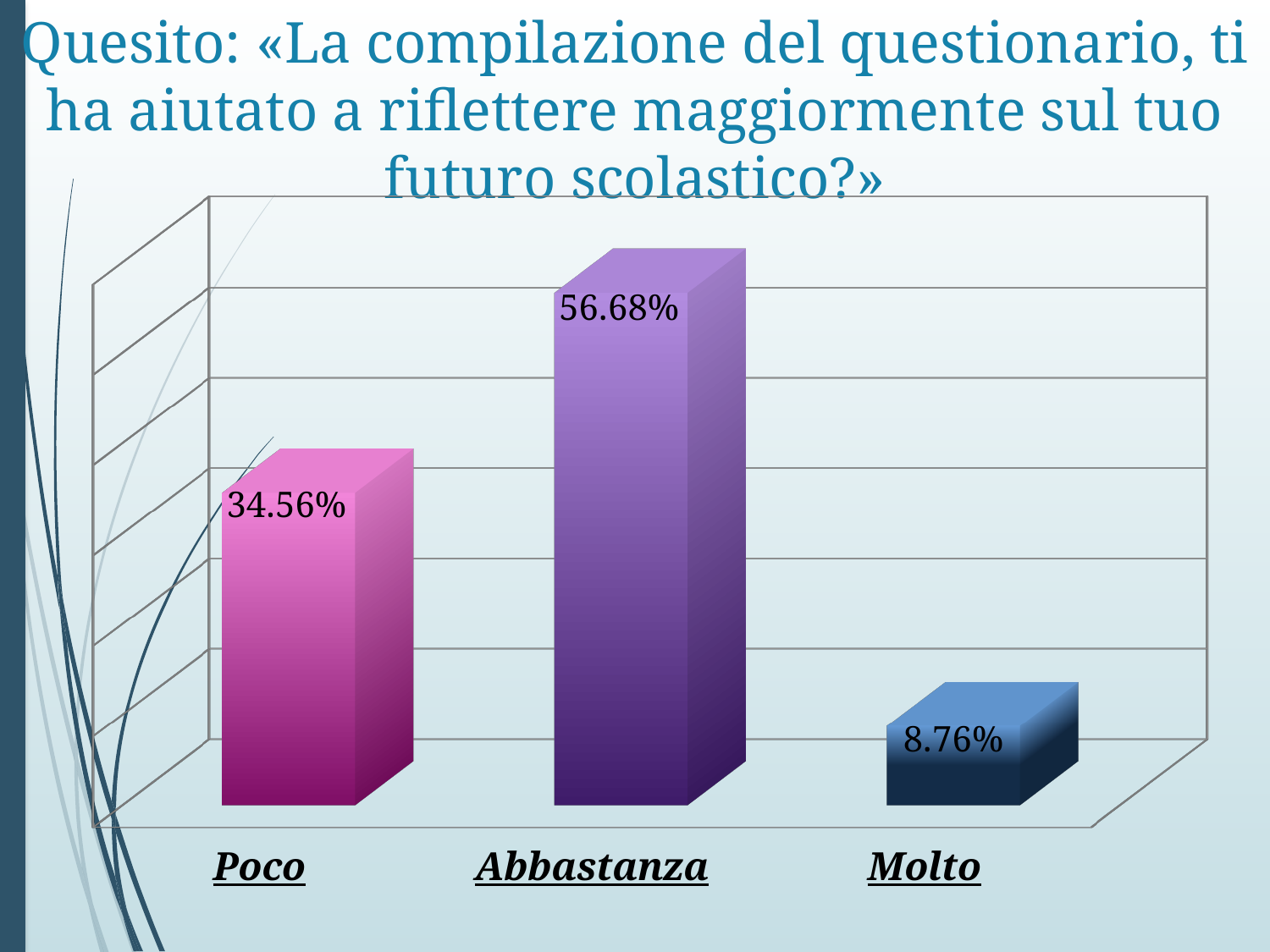
How many categories are shown in the chart? 3 What is the difference between the values for Poco and Molto? 25.80% What is the value for Molto? 8.76% Which category has the highest value? Abbastanza What is the total of the three values shown in the chart? 100% Which is larger, the value for Poco or the value for Molto? Poco What is the value for Abbastanza? 56.68% What is the difference between the values for Abbastanza and Poco? 22.12% What is the value for Poco? 34.56% What kind of chart is shown on the slide? Bar chart Which category has the lowest value? Molto What colour is the bar for Molto? Blue